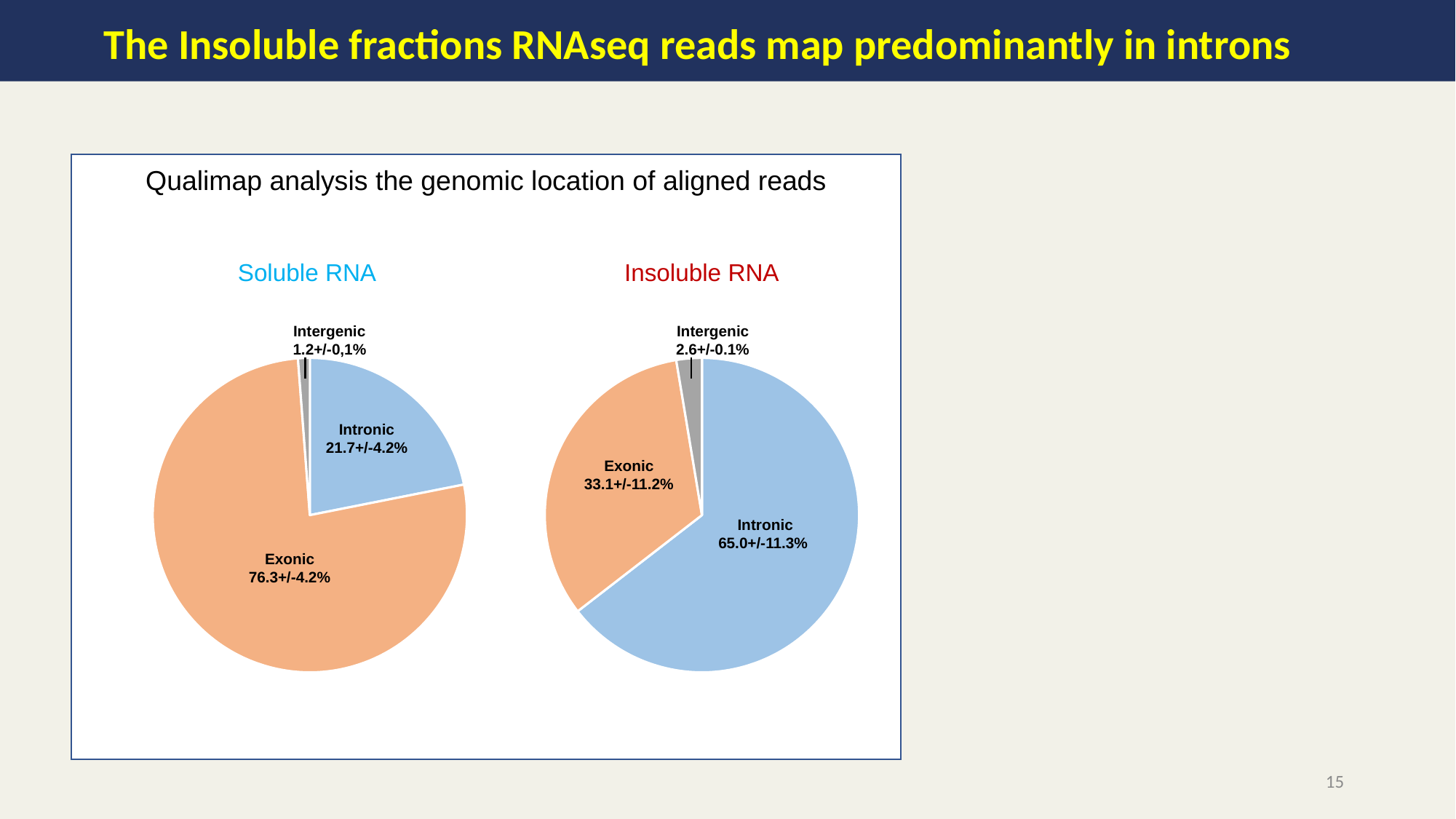
What type of chart is used for the Soluble RNA and Insoluble RNA data? Pie chart In the Insoluble RNA pie chart, is the Exonic slice larger or smaller than the Intronic slice? smaller In the Soluble RNA pie chart, what is the value shown for Exonic? 76.3+/-4.2% In the Insoluble RNA pie chart, what is the value shown for Intergenic? 2.6+/-0.1% In the Soluble RNA pie chart, which category has the largest slice? Exonic In the Insoluble RNA pie chart, what is the value shown for Exonic? 33.1+/-11.2% In the Soluble RNA pie chart, what is the value shown for Intronic? 21.7+/-4.2% In the Soluble RNA pie chart, how many percentage points larger is the Exonic value than the Intronic value (using the central values)? 54.6 How many categories does each pie chart on the slide show? 3 In the Insoluble RNA pie chart, which category has the largest slice? Intronic In the Soluble RNA pie chart, which category has the smallest slice? Intergenic In the Insoluble RNA pie chart, what is the value shown for Intronic? 65.0+/-11.3%